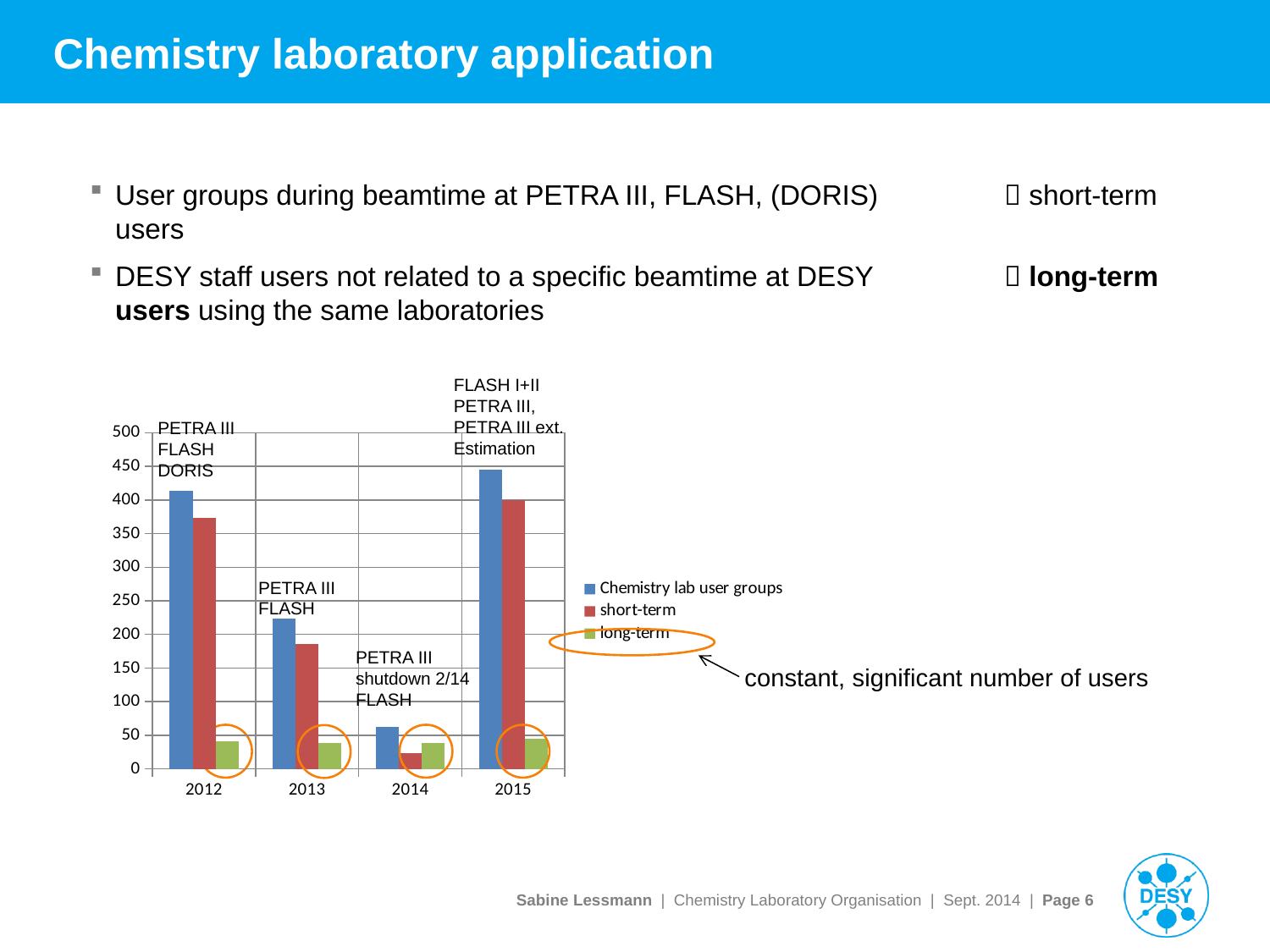
Which year has the lowest short-term value? 2014 How many series does the chart legend list? 3 Which is larger, the Chemistry lab user groups value for 2012 or for 2013? 2012 Which year has the lowest value for Chemistry lab user groups? 2014 Is the Chemistry lab user groups value for 2014 greater or less than 100? less Which series is shown in green in the chart legend? long-term Is the Chemistry lab user groups value for 2012 greater or less than 400? greater Which year has the highest value for Chemistry lab user groups? 2015 What kind of chart is shown on the slide? bar chart How many years are shown on the x axis of the chart? 4 Is the Chemistry lab user groups value for 2013 greater or less than 200? greater